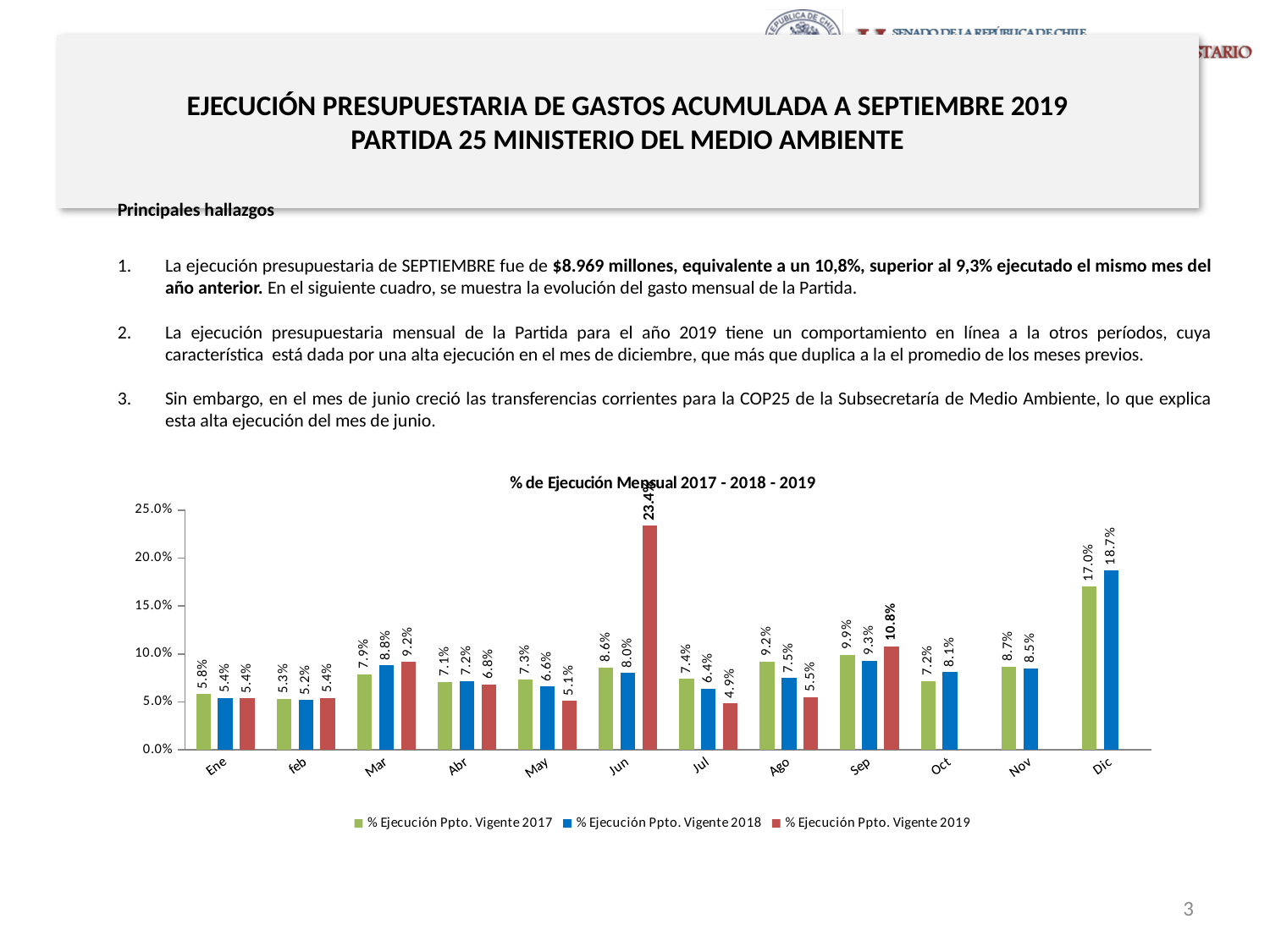
How many series does the legend list? 3 What is the value for % Ejecución Ppto. Vigente 2019 in Sep? 10.8% How many months are shown on the x axis? 12 Which month has the lowest value for % Ejecución Ppto. Vigente 2019? Jul Which is larger in Ago: the 2017 value or the 2019 value? 2017 value What is the difference between the 2018 and 2017 values in Dic? 1.7% What is the value for % Ejecución Ppto. Vigente 2017 in Sep? 9.9% Is the value for % Ejecución Ppto. Vigente 2019 in Jun greater or less than 20.0%? greater Which month has the highest value for % Ejecución Ppto. Vigente 2019? Jun What is the value for % Ejecución Ppto. Vigente 2019 in Jun? 23.4% What kind of chart is shown on the slide? Bar chart What is the value for % Ejecución Ppto. Vigente 2018 in Dic? 18.7%